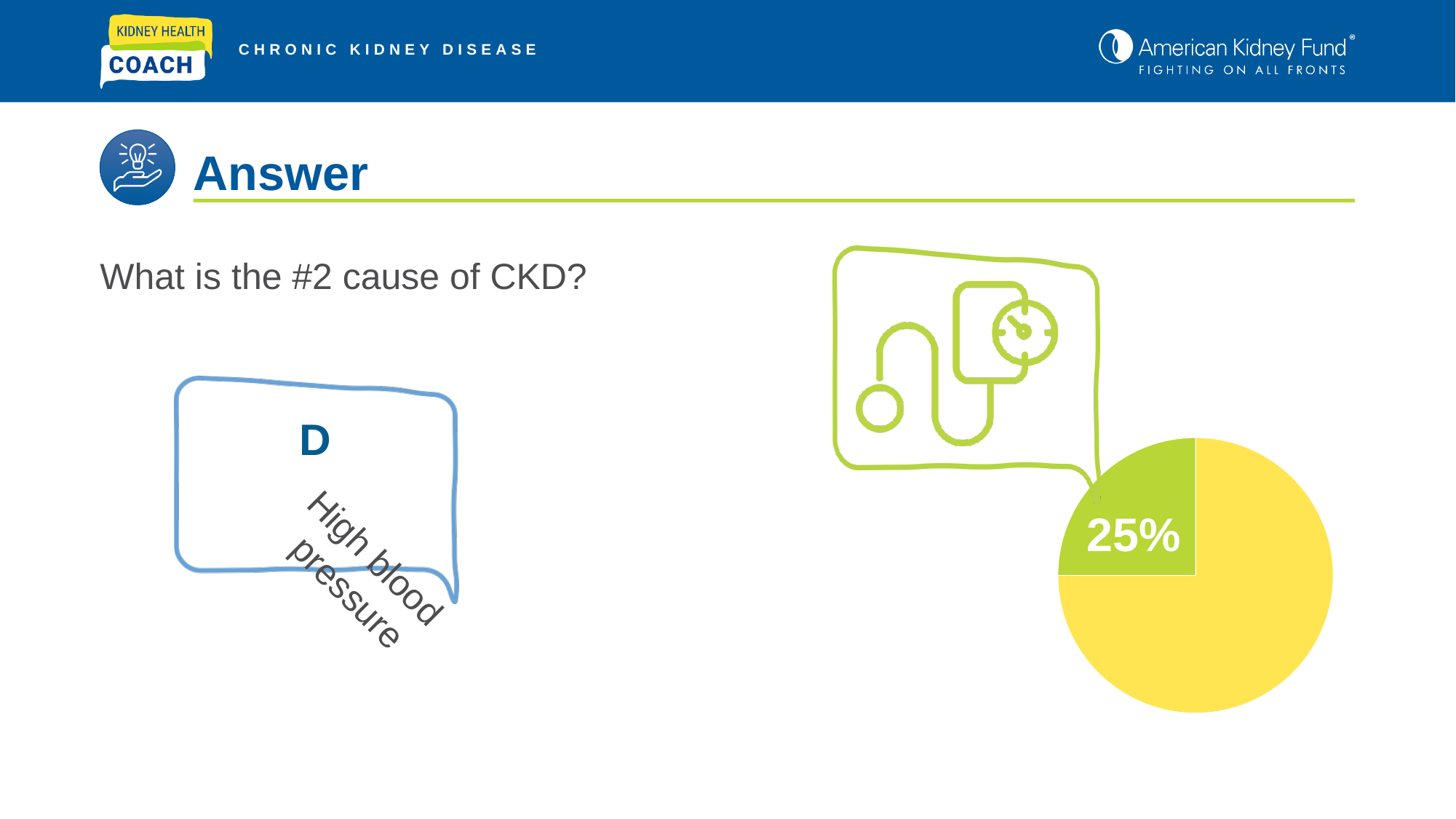
What percentage is labelled on the green slice of the pie chart? 25% Which slice of the pie chart is the smallest? the green slice (25%) What share of the pie does the green slice represent? 25% What kind of chart is shown on the right side of the slide? pie chart Is the yellow slice of the pie chart greater or less than 50% of the pie? greater Which slice of the pie chart is larger, the green slice or the yellow slice? yellow How many slices does the pie chart have? 2 What colour is the unlabelled, larger slice of the pie chart? yellow What colour is the slice of the pie chart labelled 25%? green